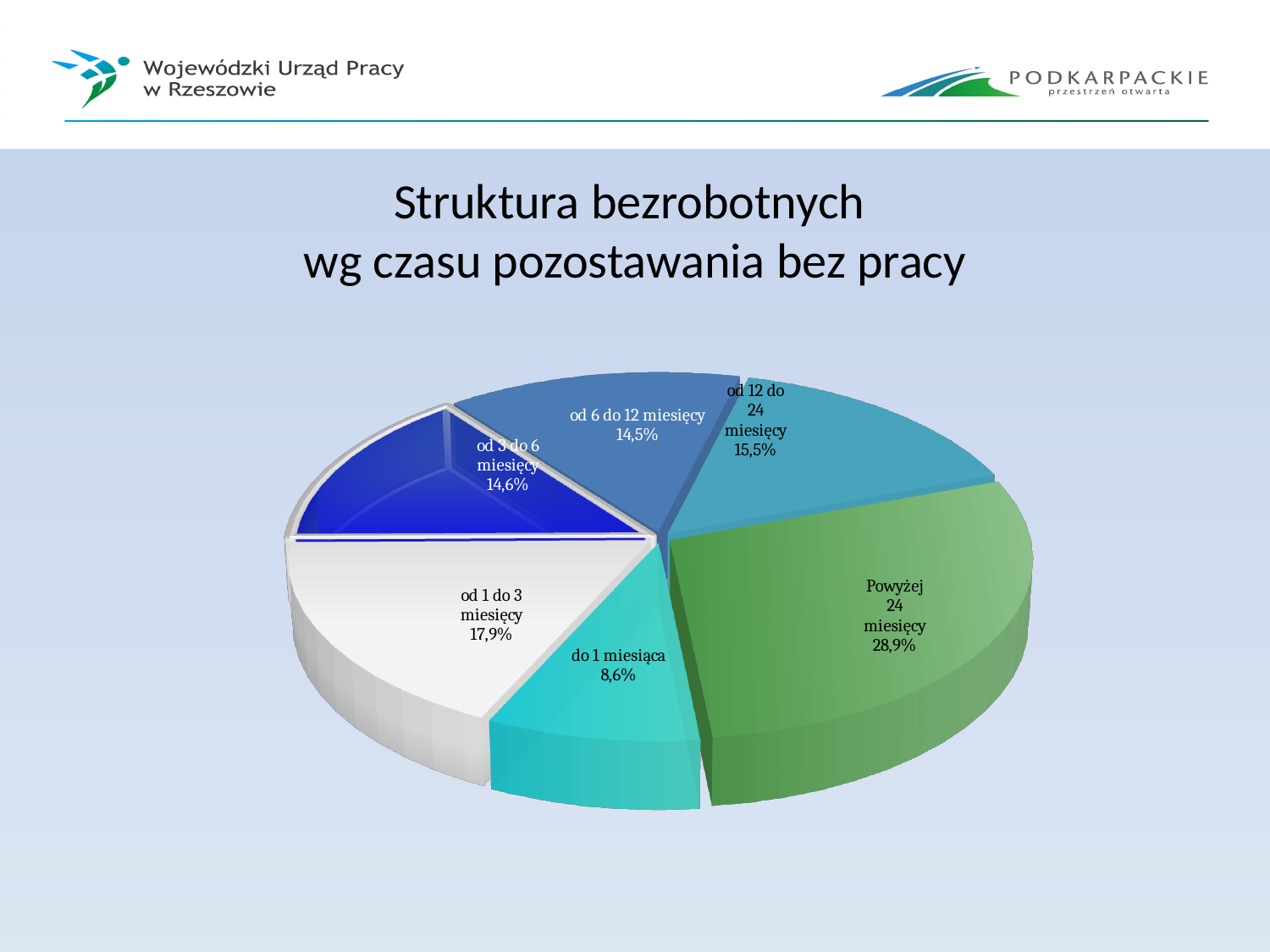
What is the value shown for "do 1 miesiąca"? 8,6% Which is larger, the share for "od 1 do 3 miesięcy" or the share for "od 12 do 24 miesięcy"? od 1 do 3 miesięcy What is the value shown for "od 1 do 3 miesięcy"? 17,9% Which category has the smallest share of the pie? do 1 miesiąca What is the difference between the shares for "Powyżej 24 miesięcy" and "do 1 miesiąca"? 20,3 percentage points What kind of chart is shown on the slide? pie chart What share of the pie is labelled "Powyżej 24 miesięcy"? 28,9% What is the title of the chart on the slide? Struktura bezrobotnych wg czasu pozostawania bez pracy What is the value shown for "od 12 do 24 miesięcy"? 15,5% Which category has the largest share of the pie? Powyżej 24 miesięcy How many slices does the pie chart have? 6 What is the value shown for "od 6 do 12 miesięcy"? 14,5%